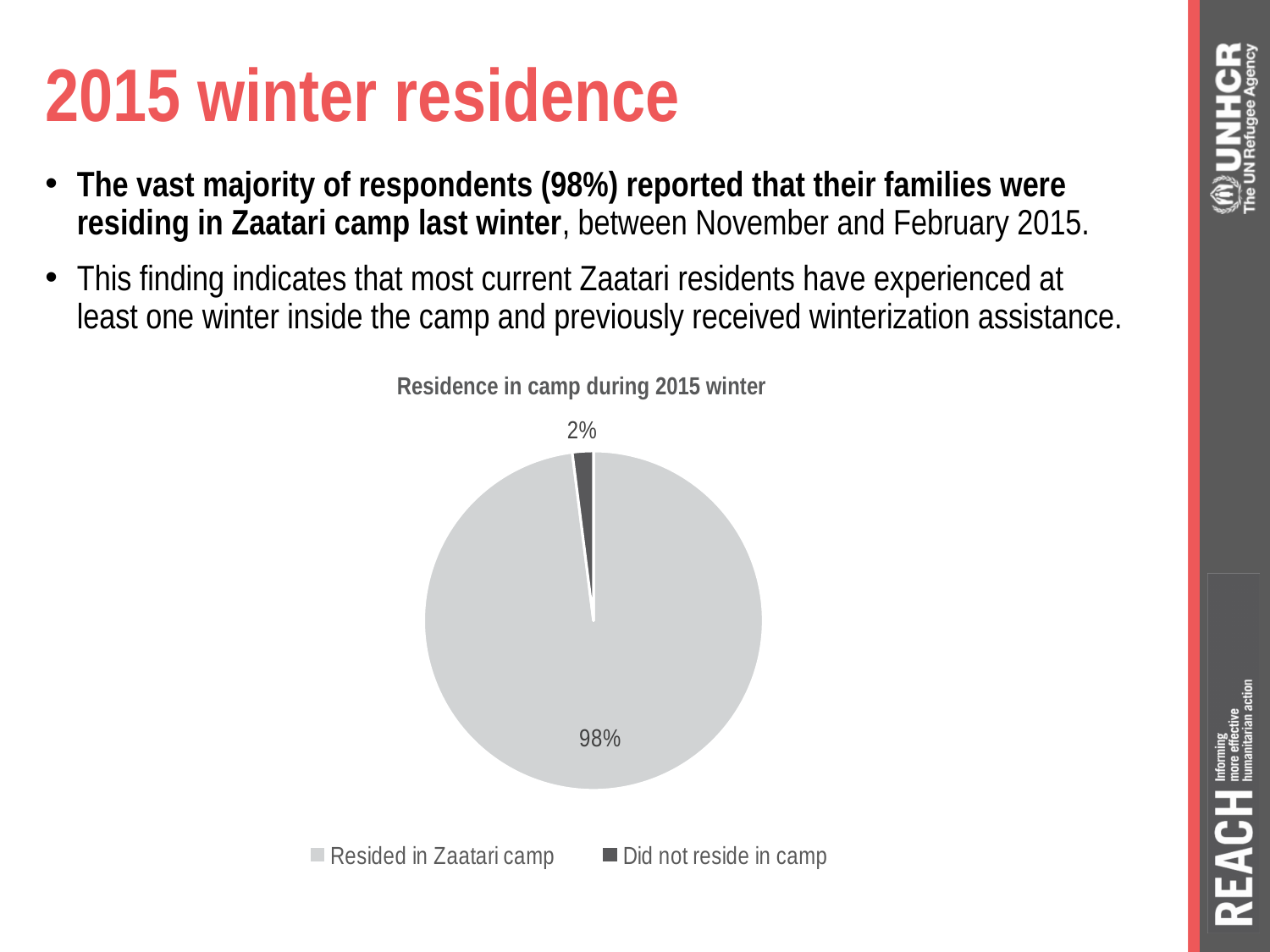
How many categories does the pie chart show? 2 Which category has the smallest slice of the pie? Did not reside in camp How many entries does the legend list? 2 What is the title of the chart? Residence in camp during 2015 winter Which legend entry is shown in dark grey? Did not reside in camp Which category has the largest slice of the pie? Resided in Zaatari camp What share of respondents did not reside in the camp during the 2015 winter? 2% What is the difference in percentage points between the 'Resided in Zaatari camp' and 'Did not reside in camp' slices? 96 Which is larger: the share that resided in Zaatari camp or the share that did not reside in camp? Resided in Zaatari camp What share of respondents resided in Zaatari camp during the 2015 winter? 98% What kind of chart is shown on the slide? pie chart